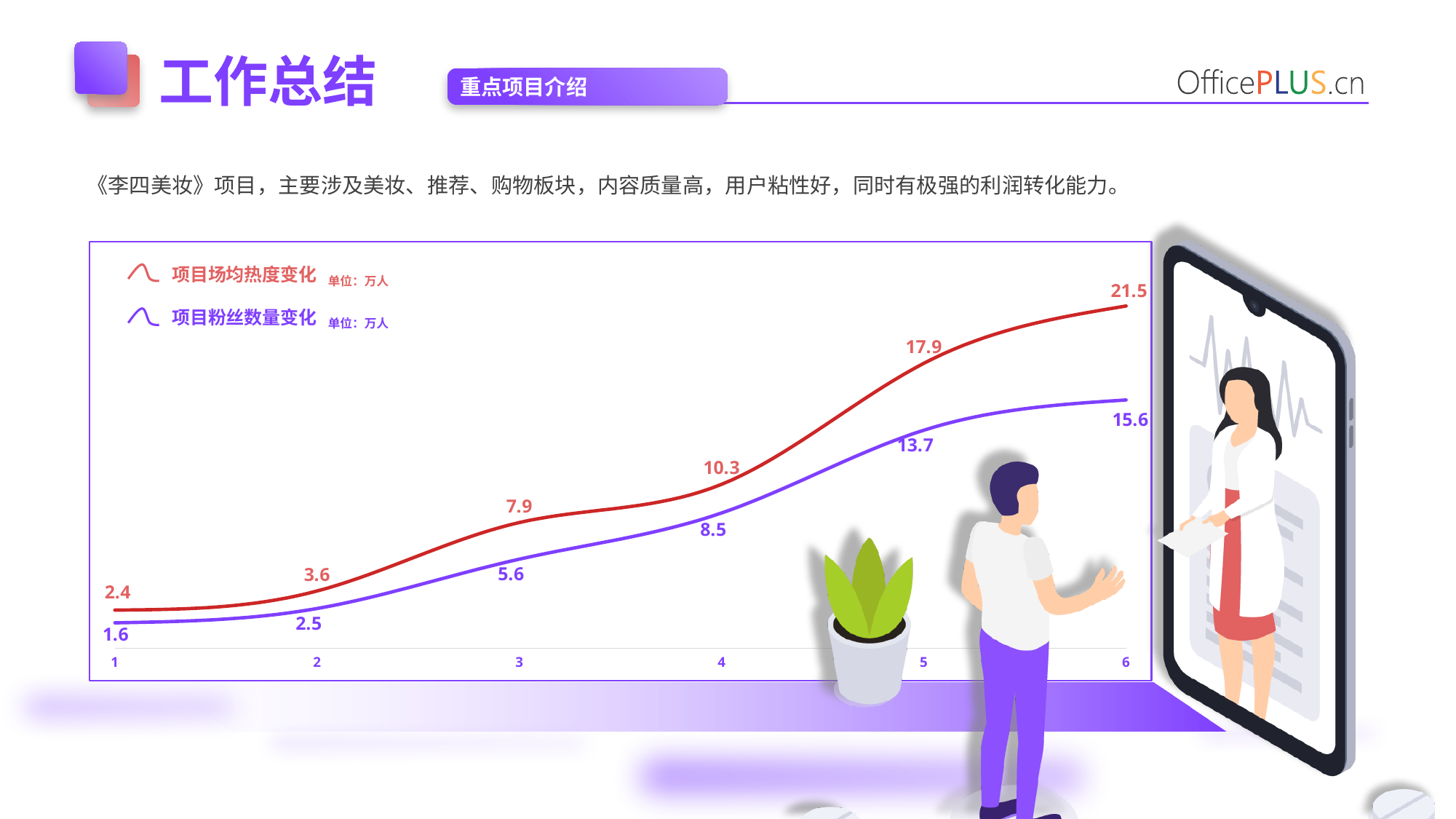
What is the value of 项目粉丝数量变化 at point 5? 13.7 What is the value of 项目场均热度变化 at point 6? 21.5 Do the values of 项目粉丝数量变化 rise or fall from point 1 to point 6? rise At which x-axis point is 项目场均热度变化 highest? 6 What is the value of 项目粉丝数量变化 at point 1? 1.6 How many x-axis points are plotted for each series? 6 What is the value of 项目场均热度变化 at point 3? 7.9 At which x-axis point is 项目粉丝数量变化 lowest? 1 What type of chart is shown on the slide? line chart Which series has the larger value at point 4, 项目场均热度变化 or 项目粉丝数量变化? 项目场均热度变化 How many series does the chart legend list? 2 What is the difference between 项目场均热度变化 and 项目粉丝数量变化 at point 6? 5.9